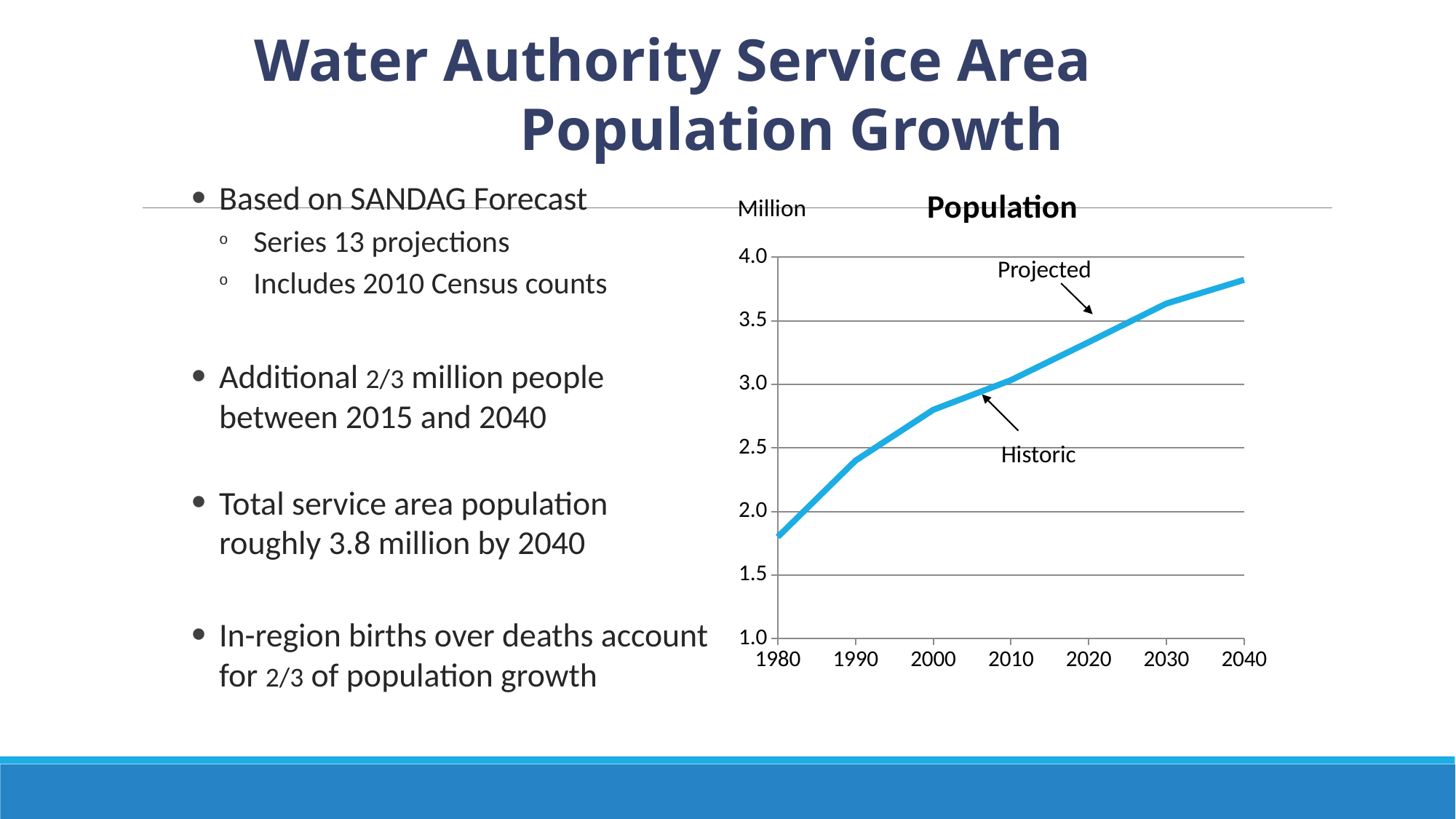
Which is larger, the value for 2020 or the value for 1990? 2020 Do the values in the chart rise or fall from 1980 to 2040? rise Is the value for 1980 greater or less than 2.0? less What kind of chart is shown on the slide? line chart How many year labels are shown on the x axis? 7 Is the value for 2000 greater or less than 2.5? greater Is the value for 1990 greater or less than 2.5? less What unit is shown at the top of the chart's vertical axis? Million Which year on the x axis has the highest population value? 2040 What is the title of the chart? Population Which year on the x axis has the lowest population value? 1980